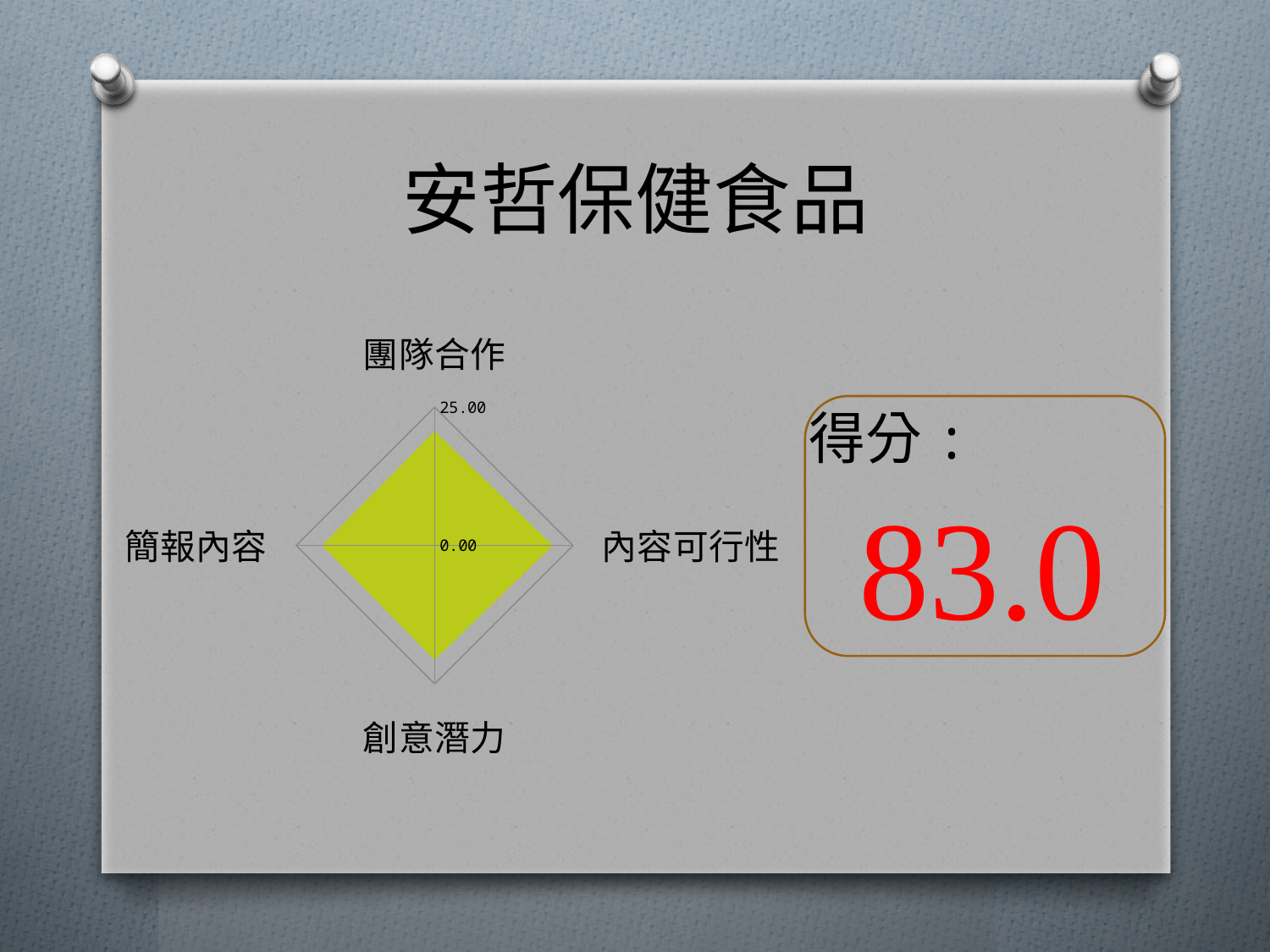
Which category label appears at the top of the radar chart? 團隊合作 What kind of chart is shown on the slide? Radar chart Is the value for 簡報內容 greater or less than 25.00? less Which category label appears at the bottom of the radar chart? 創意潛力 Is the value for 內容可行性 greater or less than 25.00? less Is the value for 團隊合作 greater or less than 25.00? less What is the title of the slide containing the radar chart? 安哲保健食品 How many categories (axes) does the radar chart have? 4